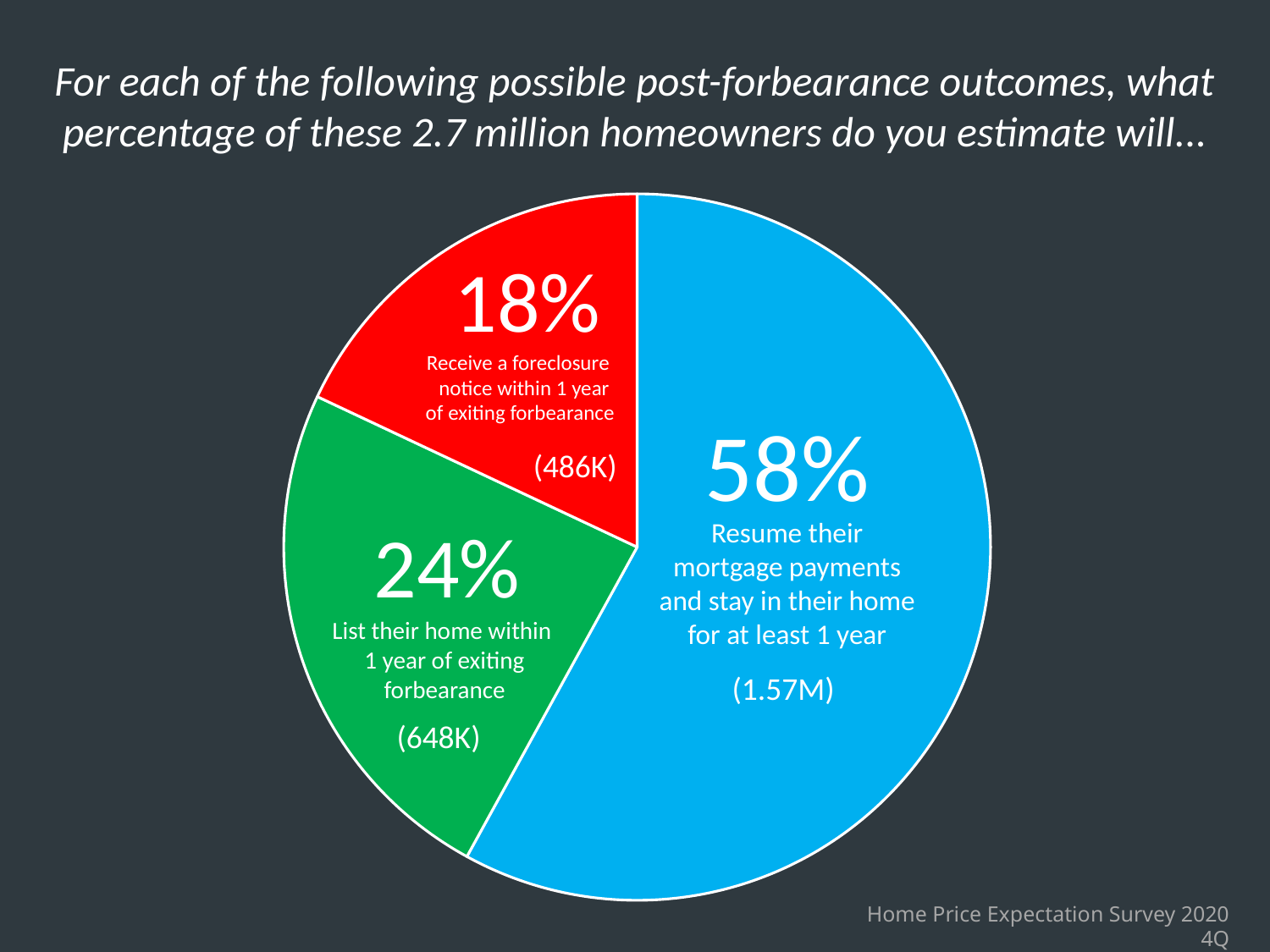
How many homeowners does the slice for listing their home within 1 year represent? 648K Which outcome has the largest share of the pie? Resume their mortgage payments and stay in their home for at least 1 year What percentage of homeowners are estimated to resume their mortgage payments and stay in their home for at least 1 year? 58% What percentage of homeowners are estimated to list their home within 1 year of exiting forbearance? 24% What is the difference in percentage points between the share that will resume mortgage payments and the share that will list their home? 34 What colour is the slice for homeowners who will resume their mortgage payments and stay in their home? blue Which is larger: the share that will list their home within 1 year or the share that will receive a foreclosure notice within 1 year? List their home within 1 year of exiting forbearance What kind of chart is shown on the slide? pie chart What percentage of homeowners are estimated to receive a foreclosure notice within 1 year of exiting forbearance? 18% How many slices does the pie chart have? 3 Which outcome has the smallest share of the pie? Receive a foreclosure notice within 1 year of exiting forbearance How many homeowners does the slice for receiving a foreclosure notice within 1 year represent? 486K